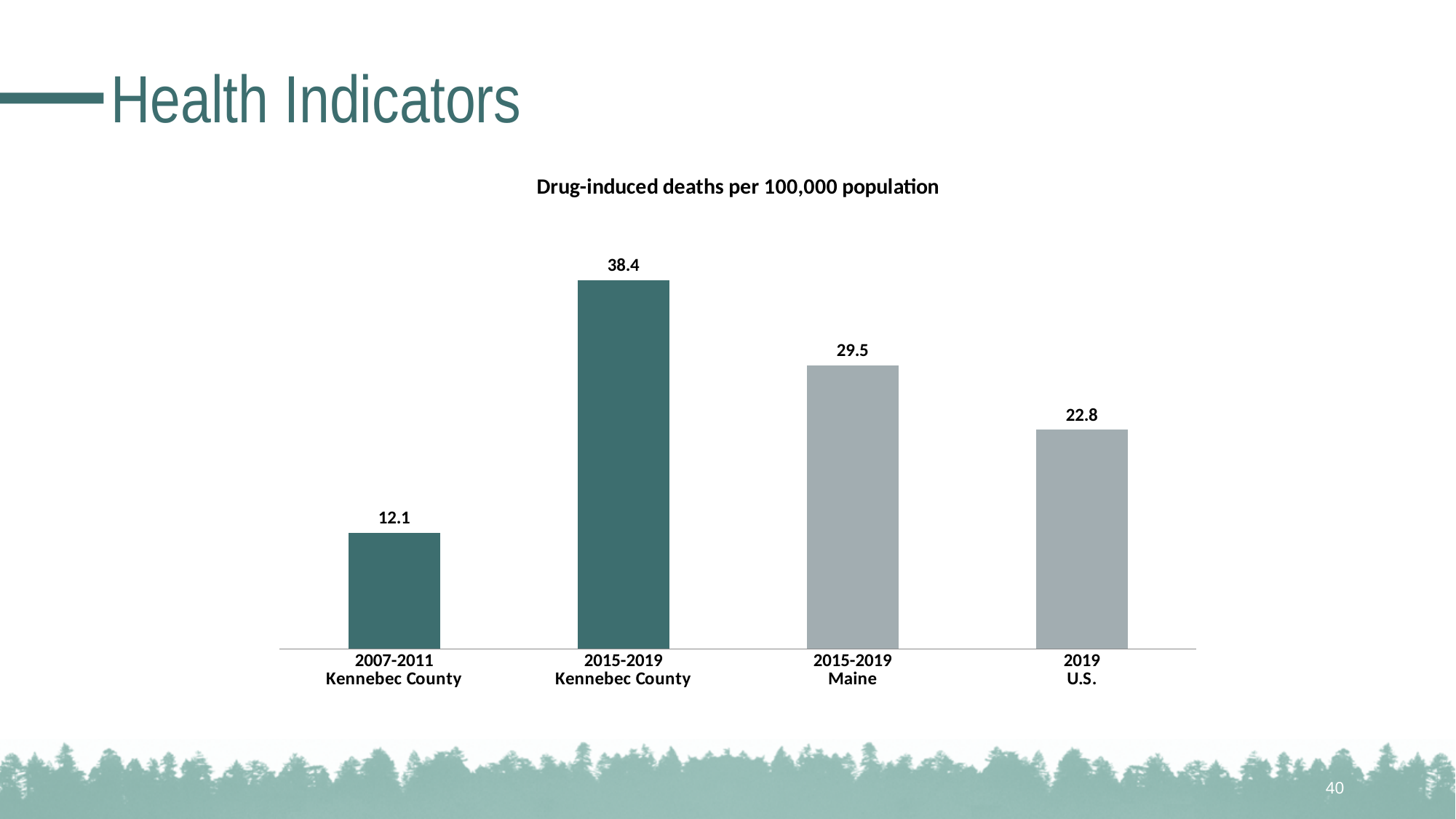
What is the value for 2015-2019 Maine? 29.5 Which category has the lowest value? 2007-2011 Kennebec County How many bars are shown in the chart? 4 What is the value for 2007-2011 Kennebec County? 12.1 What kind of chart is shown on the slide? Bar chart What is the value for 2019 U.S.? 22.8 Which category has the highest value? 2015-2019 Kennebec County What is the value for 2015-2019 Kennebec County? 38.4 What is the difference between the 2015-2019 Maine value and the 2019 U.S. value? 6.7 What is the difference between the 2015-2019 Kennebec County value and the 2007-2011 Kennebec County value? 26.3 What is the title of the chart? Drug-induced deaths per 100,000 population Which is larger, the value for 2015-2019 Maine or the value for 2019 U.S.? 2015-2019 Maine